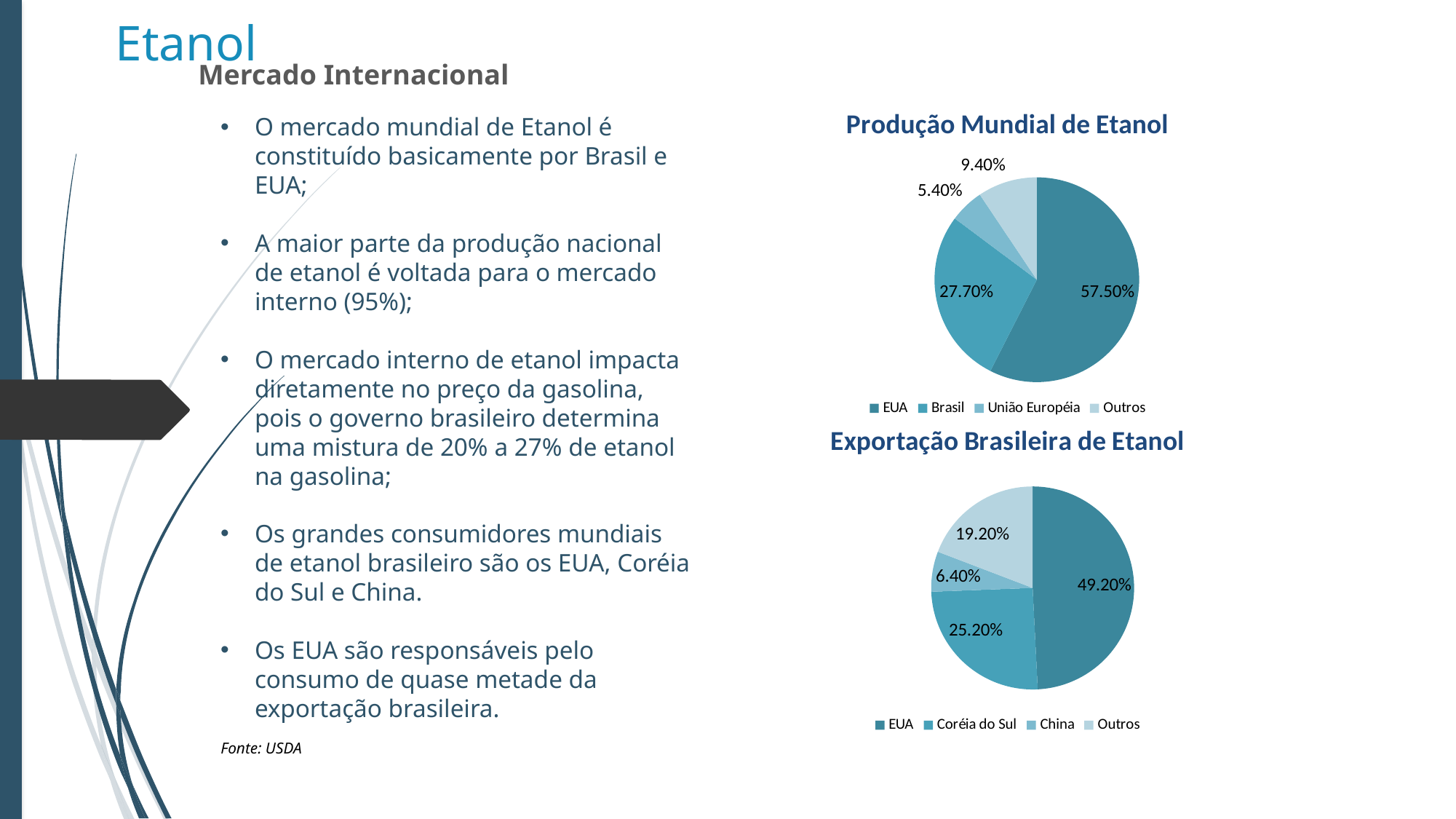
In the 'Exportação Brasileira de Etanol' chart, what share does China have? 6.40% In the 'Produção Mundial de Etanol' chart, which category has the smallest slice? União Européia What type of chart is 'Produção Mundial de Etanol'? Pie chart In the 'Produção Mundial de Etanol' chart, how many categories does the legend list? 4 In the 'Exportação Brasileira de Etanol' chart, which category has the largest slice? EUA In the 'Produção Mundial de Etanol' chart, what share does EUA have? 57.50% In the 'Produção Mundial de Etanol' chart, what is the difference between the EUA and Brasil shares? 29.80% In the 'Exportação Brasileira de Etanol' chart, what share does Coréia do Sul have? 25.20% In the 'Exportação Brasileira de Etanol' chart, which is larger, Outros or China? Outros In the 'Exportação Brasileira de Etanol' chart, what is the difference between the EUA and Outros shares? 30.00% In the 'Produção Mundial de Etanol' chart, what share does Brasil have? 27.70% What is the title of the lower chart on the slide? Exportação Brasileira de Etanol